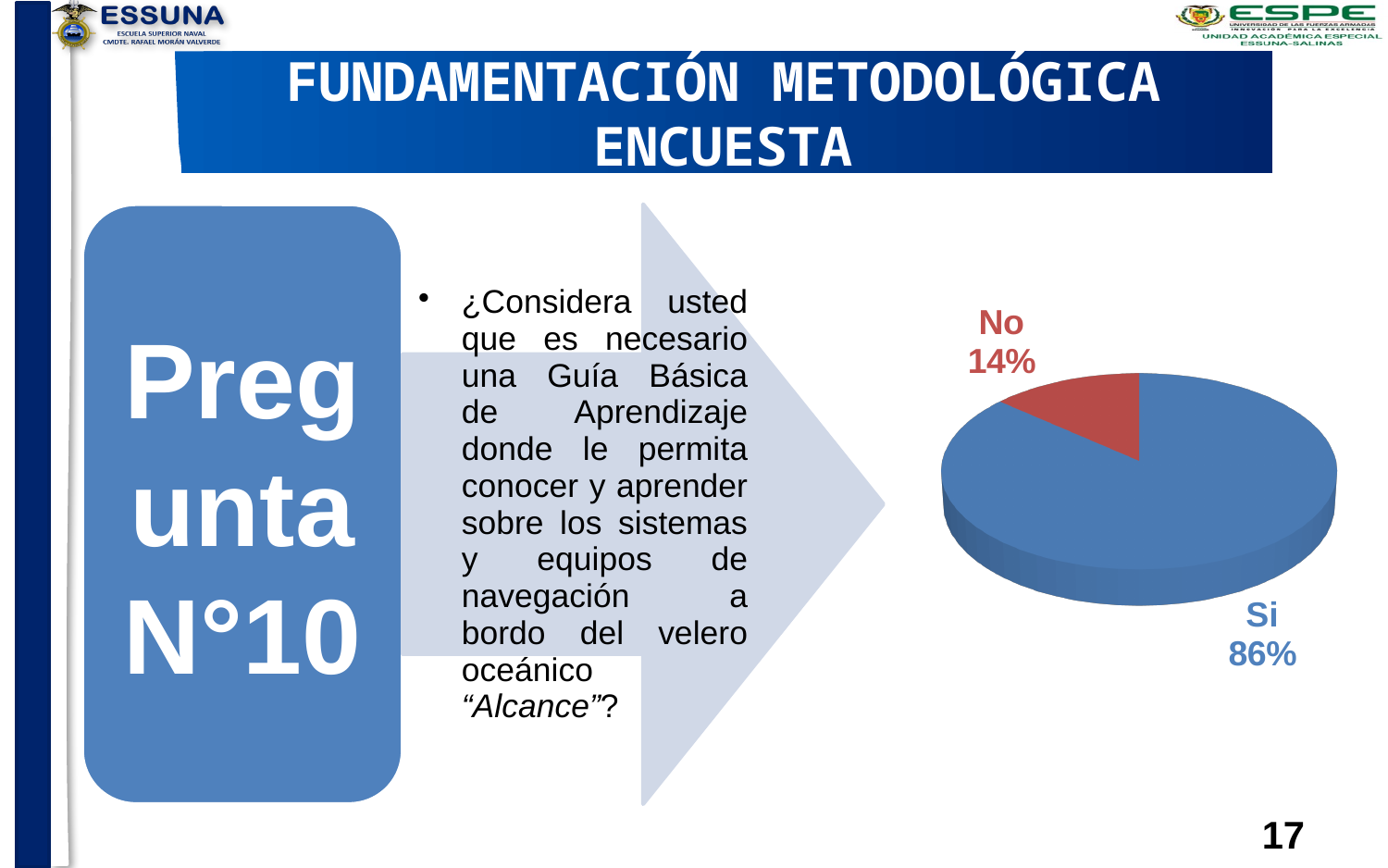
What kind of chart is shown on the slide? Pie chart Which is larger, the "Si" slice or the "No" slice? Si What colour is the "No" slice of the pie chart? Red Which slice of the pie chart is the largest? Si How many slices does the pie chart have? 2 Which slice of the pie chart is the smallest? No What share of the pie chart is labelled "Si"? 86% What share of the pie chart is labelled "No"? 14% What colour is the "Si" slice of the pie chart? Blue What is the difference in percentage points between the "Si" and "No" slices? 72